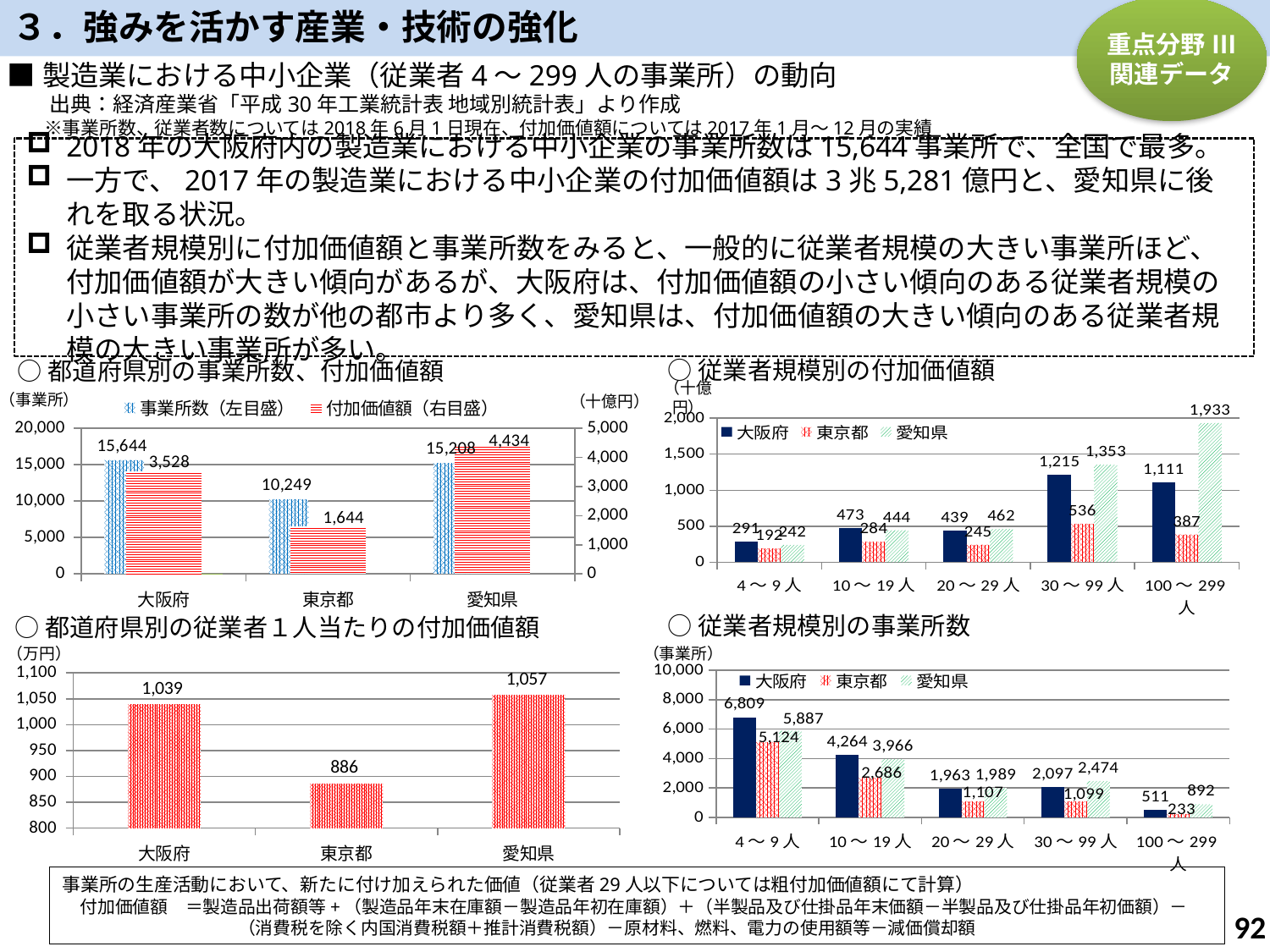
In the chart titled 都道府県別の事業所数、付加価値額, how many series does the legend list? 2 In the chart titled 従業者規模別の事業所数, what is the value for 大阪府 in the 4～9人 category? 6,809 What kind of chart is the one titled 都道府県別の従業者1人当たりの付加価値額? Bar chart In the chart titled 都道府県別の事業所数、付加価値額, what is the difference in 付加価値額 between 愛知県 and 大阪府? 906 In the chart titled 都道府県別の従業者1人当たりの付加価値額, what is the value for 東京都? 886 In the chart titled 都道府県別の従業者1人当たりの付加価値額, which is larger, the value for 大阪府 or 愛知県? 愛知県 In the chart titled 都道府県別の事業所数、付加価値額, what is the 事業所数 value for 大阪府? 15,644 In the chart titled 都道府県別の事業所数、付加価値額, which prefecture has the highest 付加価値額? 愛知県 In the chart titled 従業者規模別の事業所数, do the values for 大阪府 generally rise or fall as the employee size increases along the x axis? Fall In the chart titled 従業者規模別の付加価値額, how many employee-size categories are shown on the x axis? 5 In the chart titled 従業者規模別の付加価値額, what is the value for 愛知県 in the 100～299人 category? 1,933 In the chart titled 従業者規模別の付加価値額, which prefecture has the lowest value in the 30～99人 category? 東京都